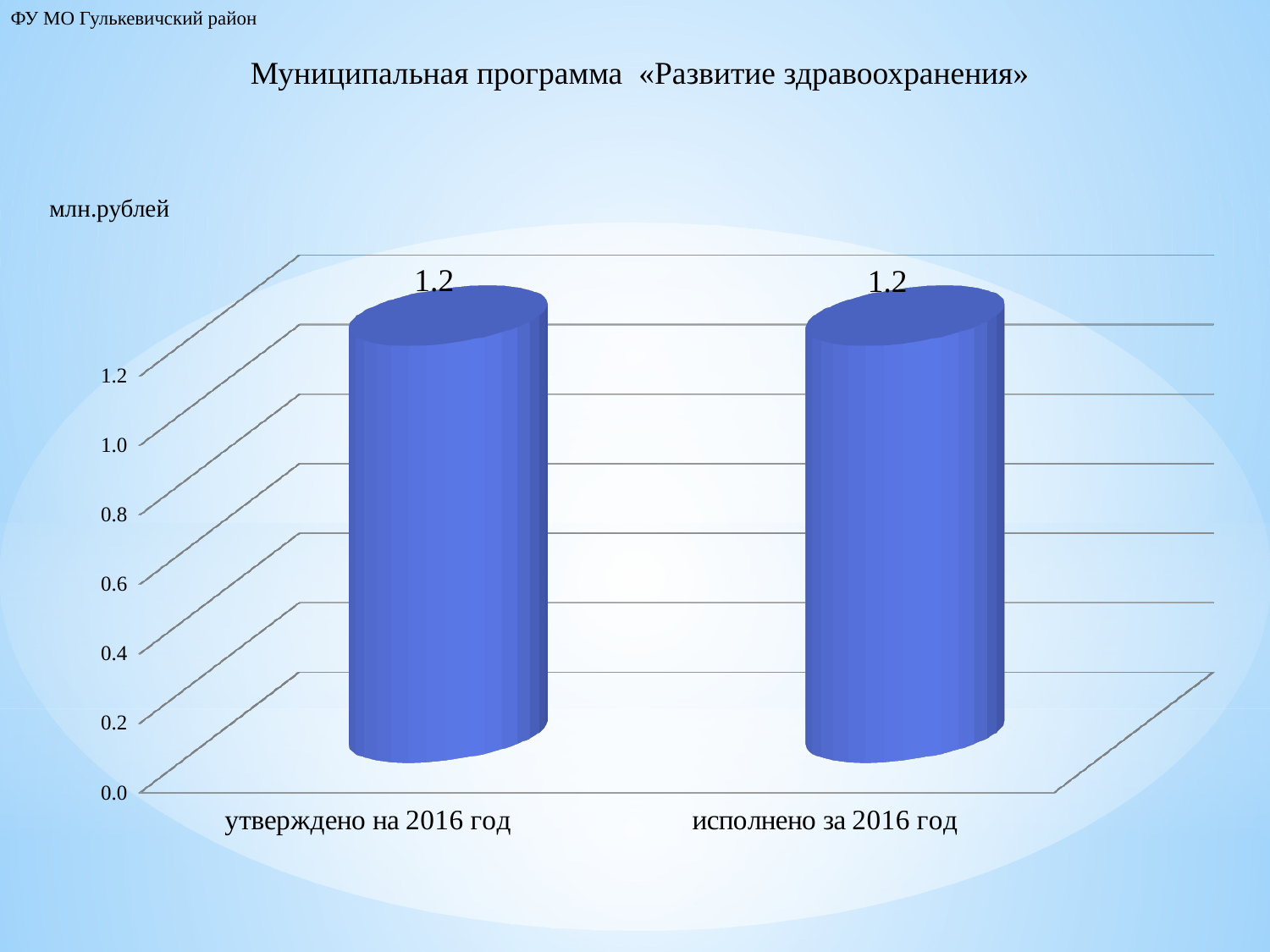
How many categories are shown on the chart? 2 Is the value for «исполнено за 2016 год» greater or less than 1.0? greater In what units are the values on the chart expressed? млн.рублей What is the value for «исполнено за 2016 год»? 1.2 What kind of chart is shown on the slide? bar chart What is the title of the chart on the slide? Муниципальная программа «Развитие здравоохранения» What is the difference between the value for «утверждено на 2016 год» and the value for «исполнено за 2016 год»? 0.0 Is the value for «утверждено на 2016 год» greater or less than 0.8? greater Do the values rise, fall or stay the same from «утверждено на 2016 год» to «исполнено за 2016 год»? stay the same What is the value for «утверждено на 2016 год»? 1.2